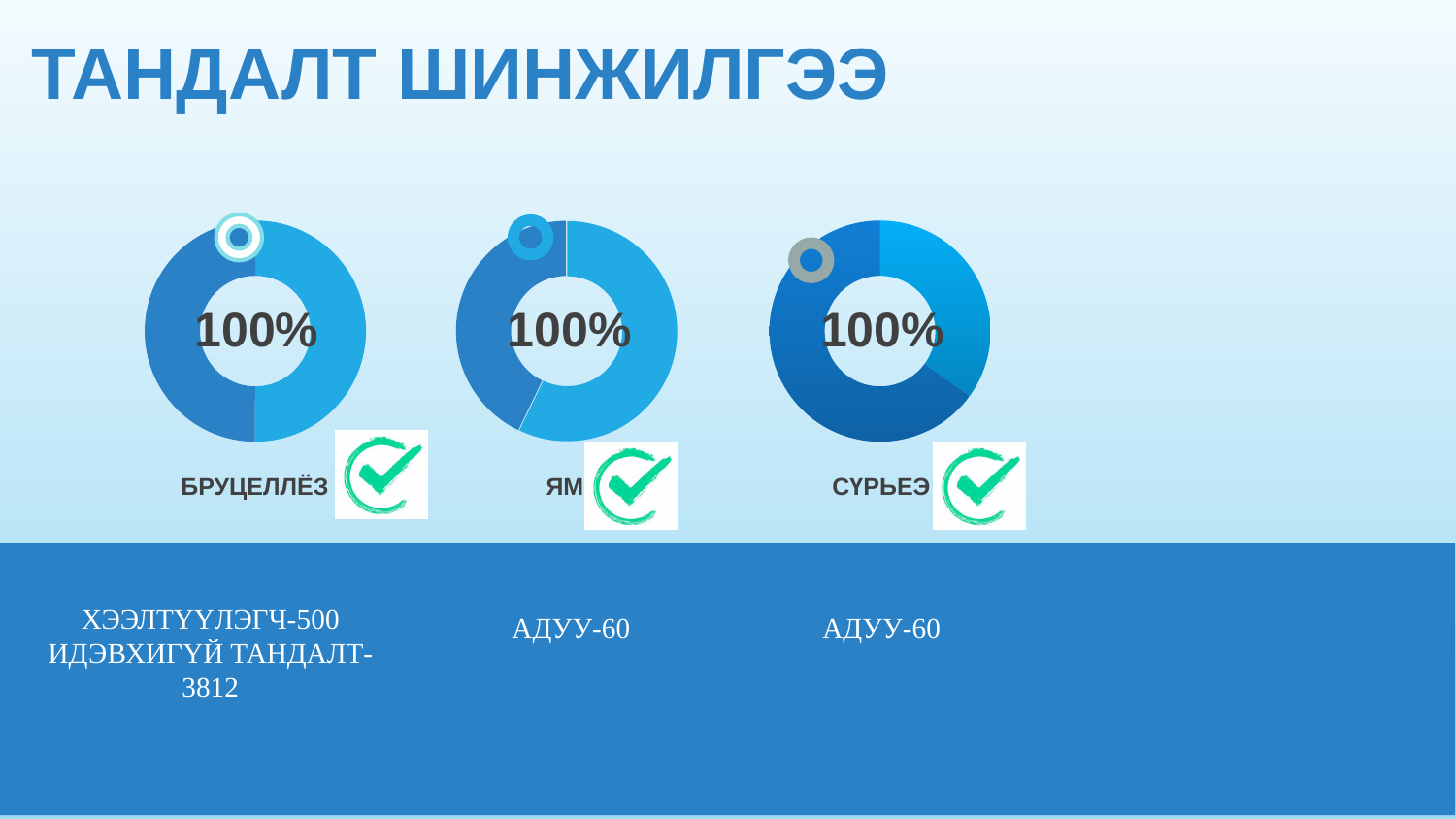
What is the label under the rightmost donut chart? СҮРЬЕЭ How many donut charts are shown on the slide? 3 What percentage is printed in the centre of the СҮРЬЕЭ donut chart? 100% Do the three donut charts show the same percentage value in their centres? Yes, 100% What kind of chart is used for БРУЦЕЛЛЁЗ on the slide? Donut chart Is the percentage shown in the centre of the ЯМ donut chart greater or less than 50%? greater What is the label under the leftmost donut chart? БРУЦЕЛЛЁЗ What percentage is printed in the centre of the БРУЦЕЛЛЁЗ donut chart? 100% What percentage is printed in the centre of the ЯМ donut chart? 100%